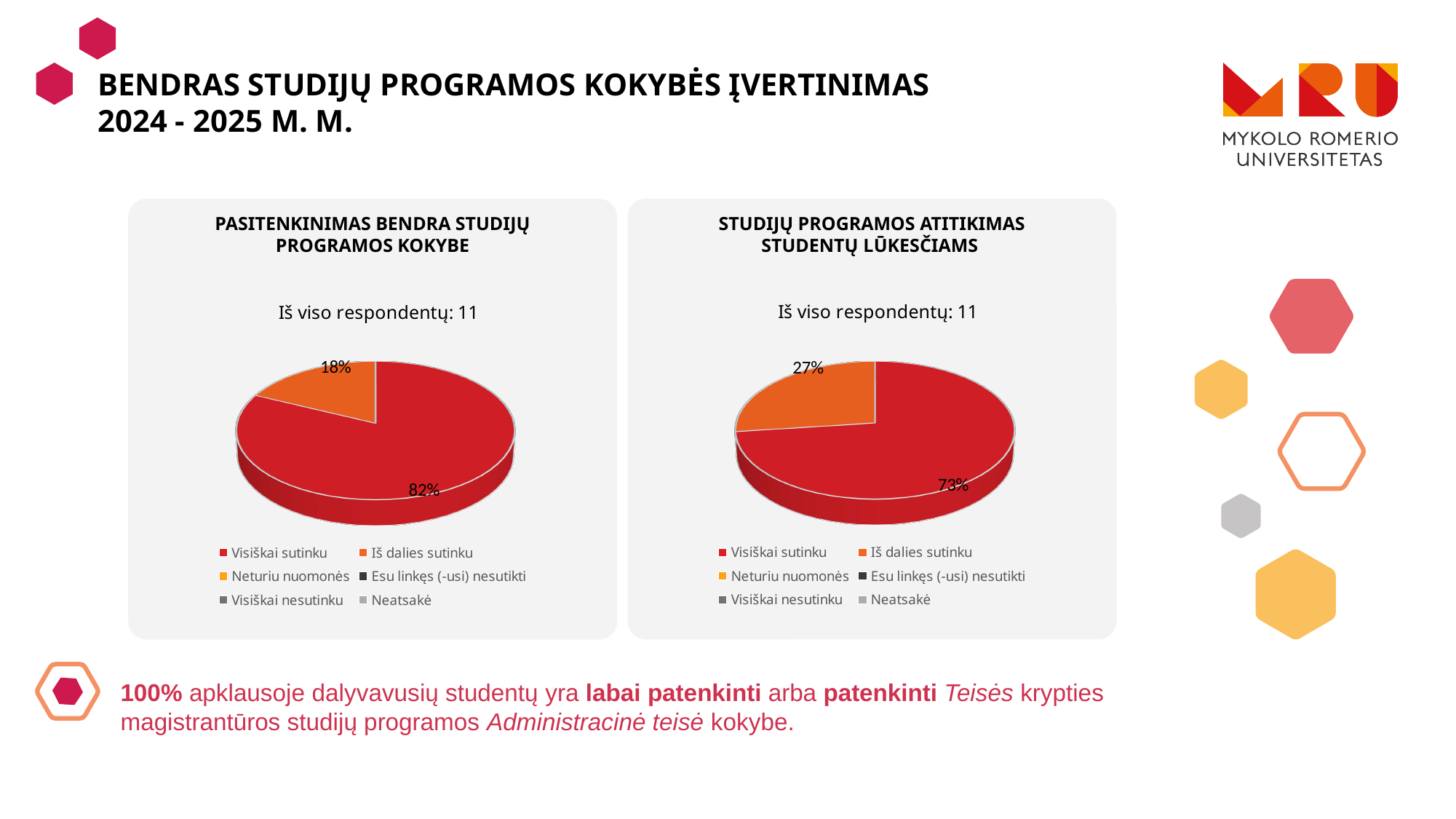
In the chart titled "PASITENKINIMAS BENDRA STUDIJŲ PROGRAMOS KOKYBE", what share of the pie is "Visiškai sutinku"? 82% In the left chart, which category has the largest slice? Visiškai sutinku How many respondents does the left chart report in total? 11 In the chart titled "STUDIJŲ PROGRAMOS ATITIKIMAS STUDENTŲ LŪKESČIAMS", what share of the pie is "Iš dalies sutinku"? 27% In the right chart, which category has the smallest visible slice? Iš dalies sutinku In the right chart, what is the difference in percentage points between the "Visiškai sutinku" and "Iš dalies sutinku" slices? 46 In the chart titled "PASITENKINIMAS BENDRA STUDIJŲ PROGRAMOS KOKYBE", what share of the pie is "Iš dalies sutinku"? 18% In the left chart, what is the difference in percentage points between the "Visiškai sutinku" and "Iš dalies sutinku" slices? 64 How many entries does the legend of the right chart list? 6 Which chart has the larger "Iš dalies sutinku" share, the left chart or the right chart? the right chart What kind of chart is used in the chart titled "PASITENKINIMAS BENDRA STUDIJŲ PROGRAMOS KOKYBE"? pie chart